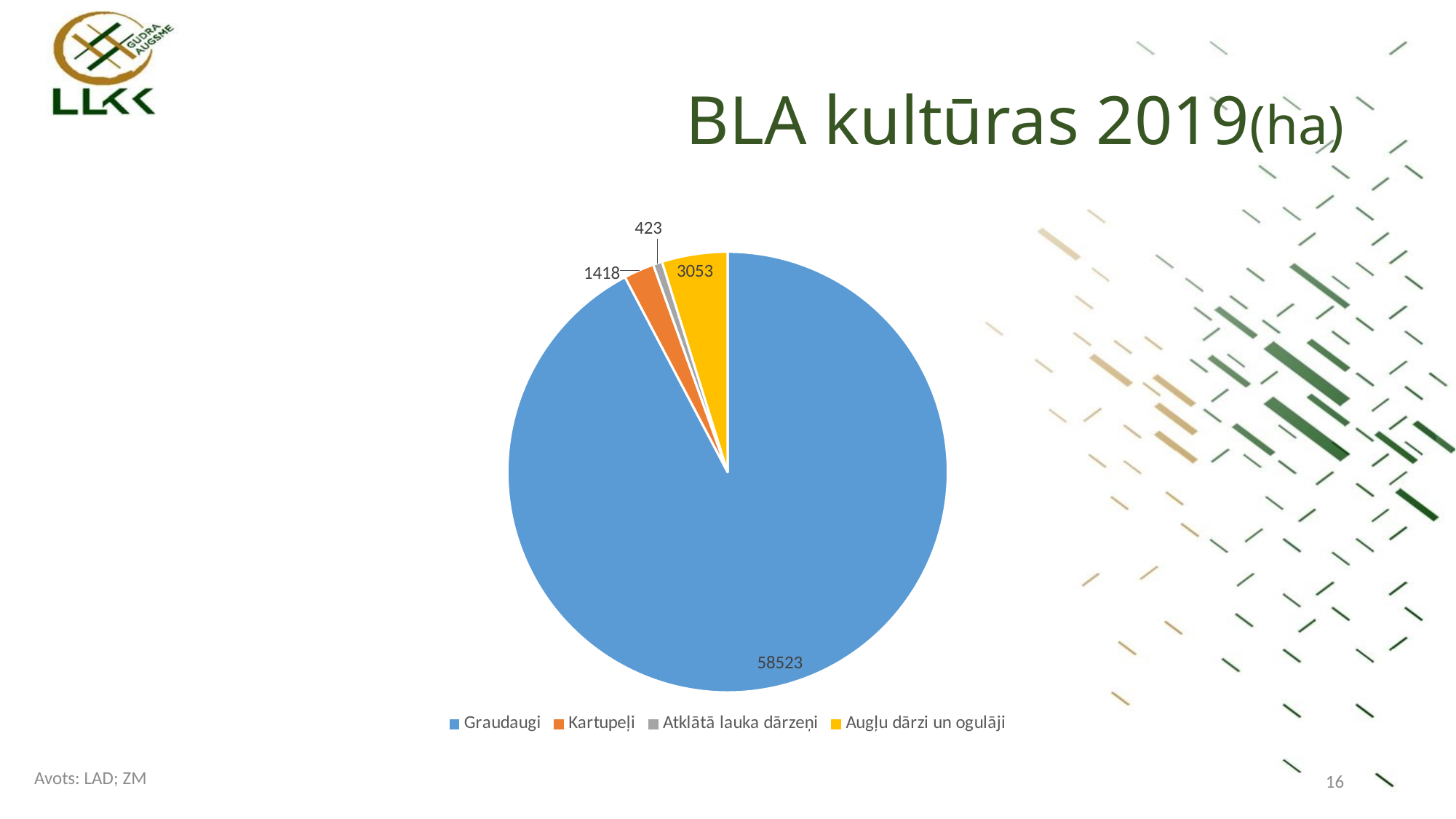
Which is larger, the value for Kartupeļi or the value for Augļu dārzi un ogulāji? Augļu dārzi un ogulāji How many categories does the pie chart show? 4 What is the difference between the values for Kartupeļi and Atklātā lauka dārzeņi? 995 What is the value for Atklātā lauka dārzeņi? 423 Which category has the smallest slice of the pie? Atklātā lauka dārzeņi What is the value for Kartupeļi? 1418 What is the value for Augļu dārzi un ogulāji? 3053 What is the value for Graudaugi? 58523 What is the difference between the values for Augļu dārzi un ogulāji and Kartupeļi? 1635 Which category has the largest slice of the pie? Graudaugi What is the title of the slide containing the chart? BLA kultūras 2019(ha) What type of chart is shown on the slide? pie chart